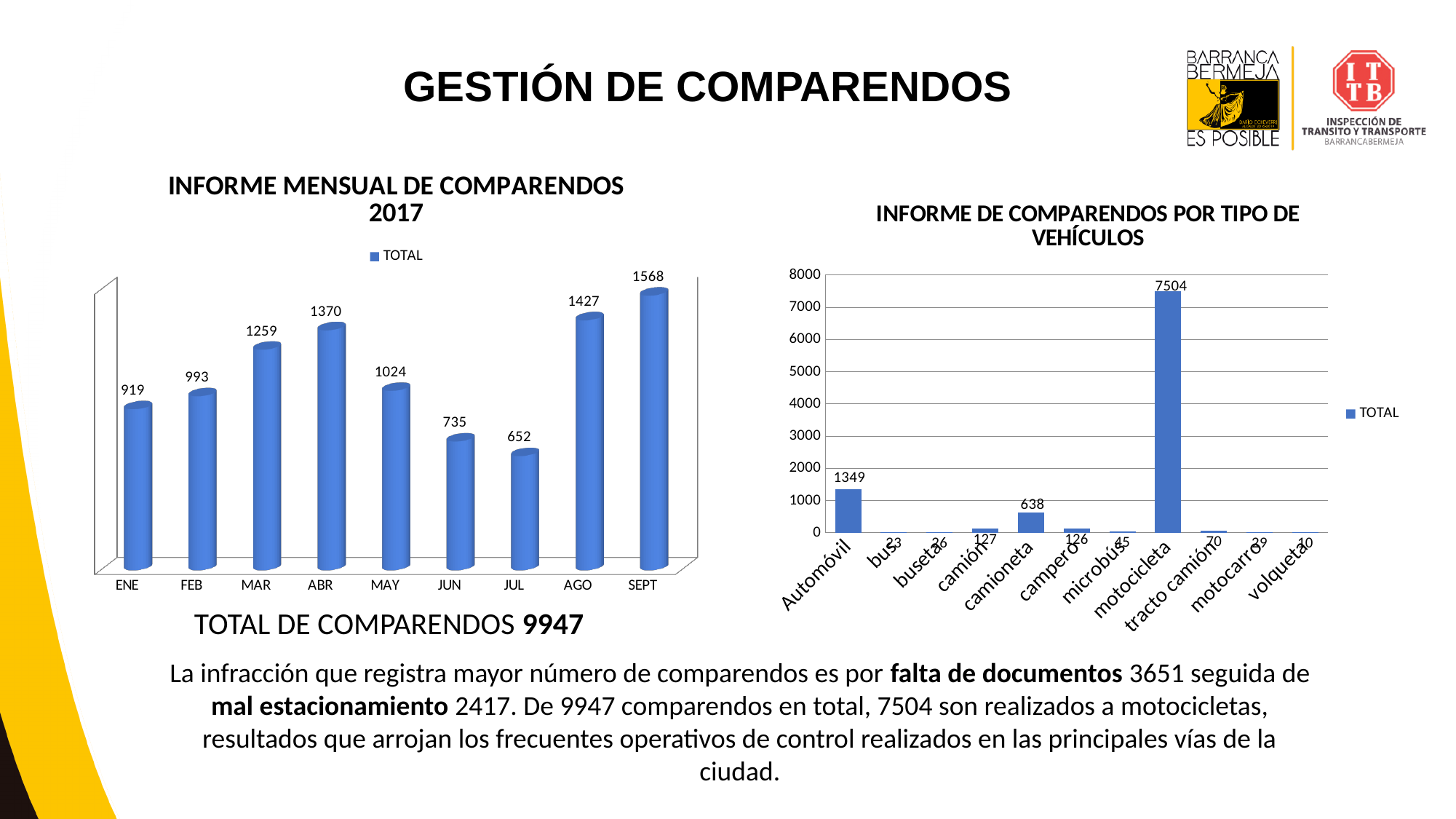
In the chart titled INFORME MENSUAL DE COMPARENDOS 2017, which is larger, the value for FEB or the value for MAY? MAY What kind of chart is the one titled INFORME DE COMPARENDOS POR TIPO DE VEHÍCULOS? bar chart In the chart titled INFORME MENSUAL DE COMPARENDOS 2017, what is the value for SEPT? 1568 In the chart titled INFORME MENSUAL DE COMPARENDOS 2017, what is the difference between the values for ABR and MAR? 111 In the chart titled INFORME DE COMPARENDOS POR TIPO DE VEHÍCULOS, is the value for Automóvil greater or less than 1000? greater In the chart titled INFORME DE COMPARENDOS POR TIPO DE VEHÍCULOS, what is the value for camioneta? 638 In the chart titled INFORME MENSUAL DE COMPARENDOS 2017, what is the value for JUL? 652 In the chart titled INFORME MENSUAL DE COMPARENDOS 2017, which month has the highest value? SEPT In the chart titled INFORME DE COMPARENDOS POR TIPO DE VEHÍCULOS, which vehicle type has the highest value? motocicleta In the chart titled INFORME DE COMPARENDOS POR TIPO DE VEHÍCULOS, what is the value for motocicleta? 7504 In the chart titled INFORME MENSUAL DE COMPARENDOS 2017, which month has the lowest value? JUL In the chart titled INFORME MENSUAL DE COMPARENDOS 2017, how many months are shown on the x axis? 9